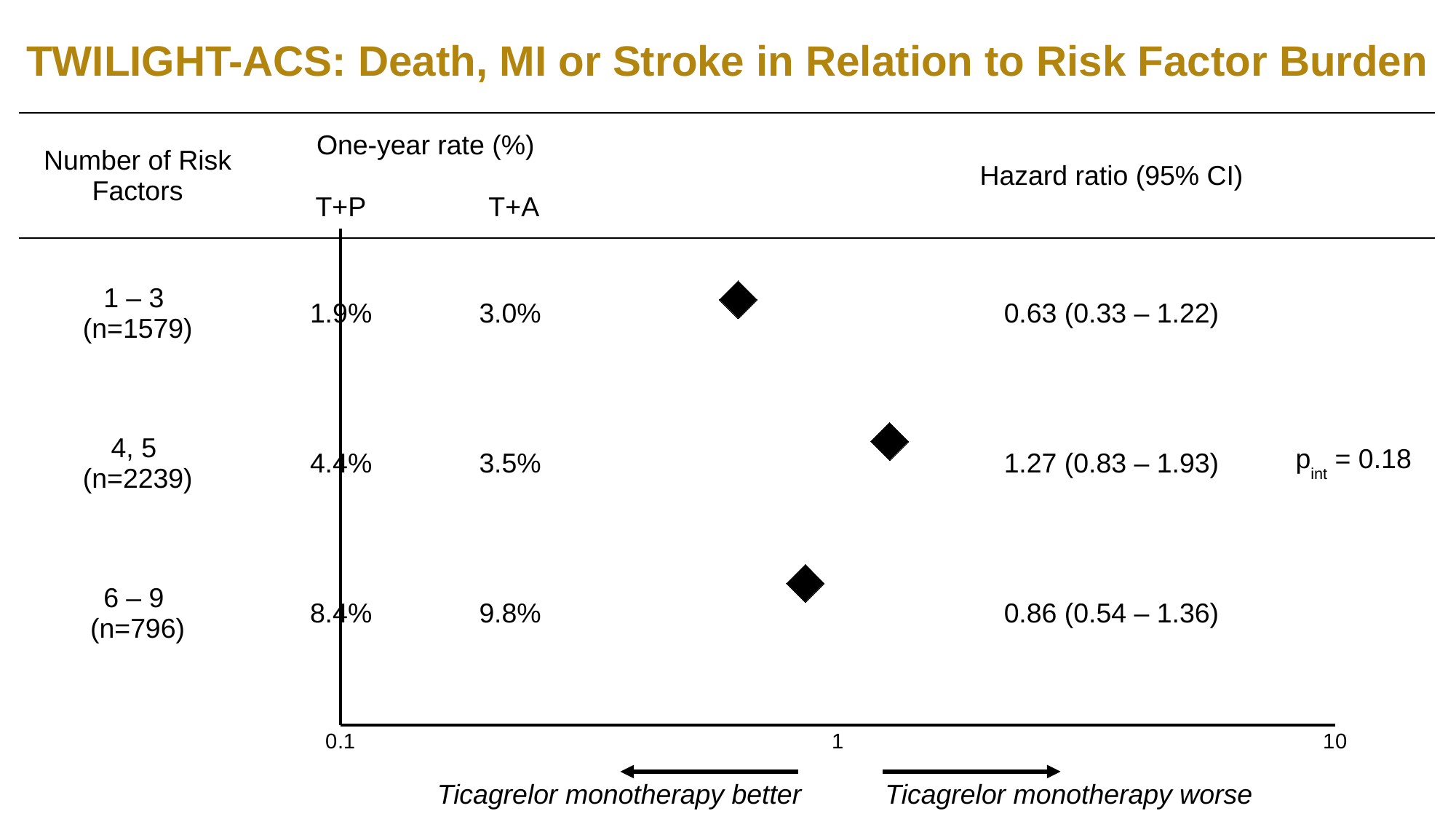
What is the one-year T+P event rate for patients with 6 – 9 risk factors? 8.4% How many patients are in the 4, 5 risk factor subgroup? n=2239 Which risk factor subgroup has the lowest hazard ratio? 1 – 3 What is the one-year T+A event rate for patients with 1 – 3 risk factors? 3.0% For the 4, 5 risk factor subgroup, which arm has the higher one-year event rate, T+P or T+A? T+P What is the p-value for interaction shown on the slide? 0.18 What is the hazard ratio point estimate for patients with 4, 5 risk factors? 1.27 What is the hazard ratio (95% CI) for patients with 1 – 3 risk factors? 0.63 (0.33 – 1.22) How many risk factor subgroups are plotted on the forest plot? 3 For the 6 – 9 risk factor subgroup, what is the difference between the T+A and T+P one-year rates? 1.4 percentage points Which risk factor subgroup has the highest hazard ratio? 4, 5 Is the hazard ratio for the 6 – 9 risk factor subgroup greater or less than 1? less